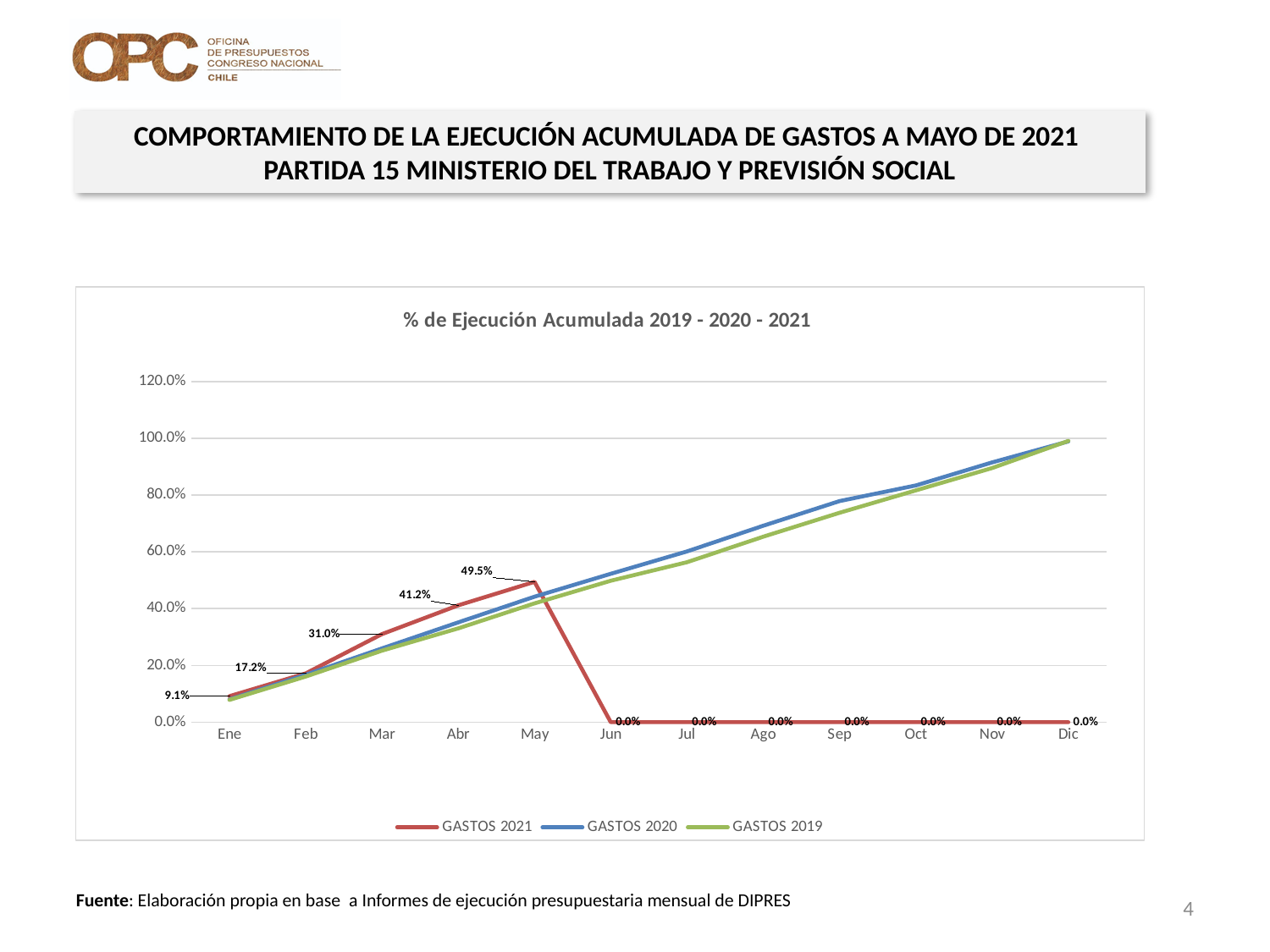
What is the value for GASTOS 2021 in Ene? 9.1% What kind of chart is shown on the slide? Line chart How many series does the legend list? 3 What is the difference between the GASTOS 2021 values for May and Abr? 8.3 percentage points Which is larger in Sep, GASTOS 2020 or GASTOS 2019? GASTOS 2020 Is the value for GASTOS 2020 in Sep greater or less than 60.0%? greater Is the value for GASTOS 2019 in Jul greater or less than 80.0%? less What is the value for GASTOS 2021 in May? 49.5% What is the value for GASTOS 2021 in Mar? 31.0% In which month does GASTOS 2021 reach its highest labeled value? May How many months are shown on the x axis? 12 What is the difference between the GASTOS 2021 values for Feb and Ene? 8.1 percentage points